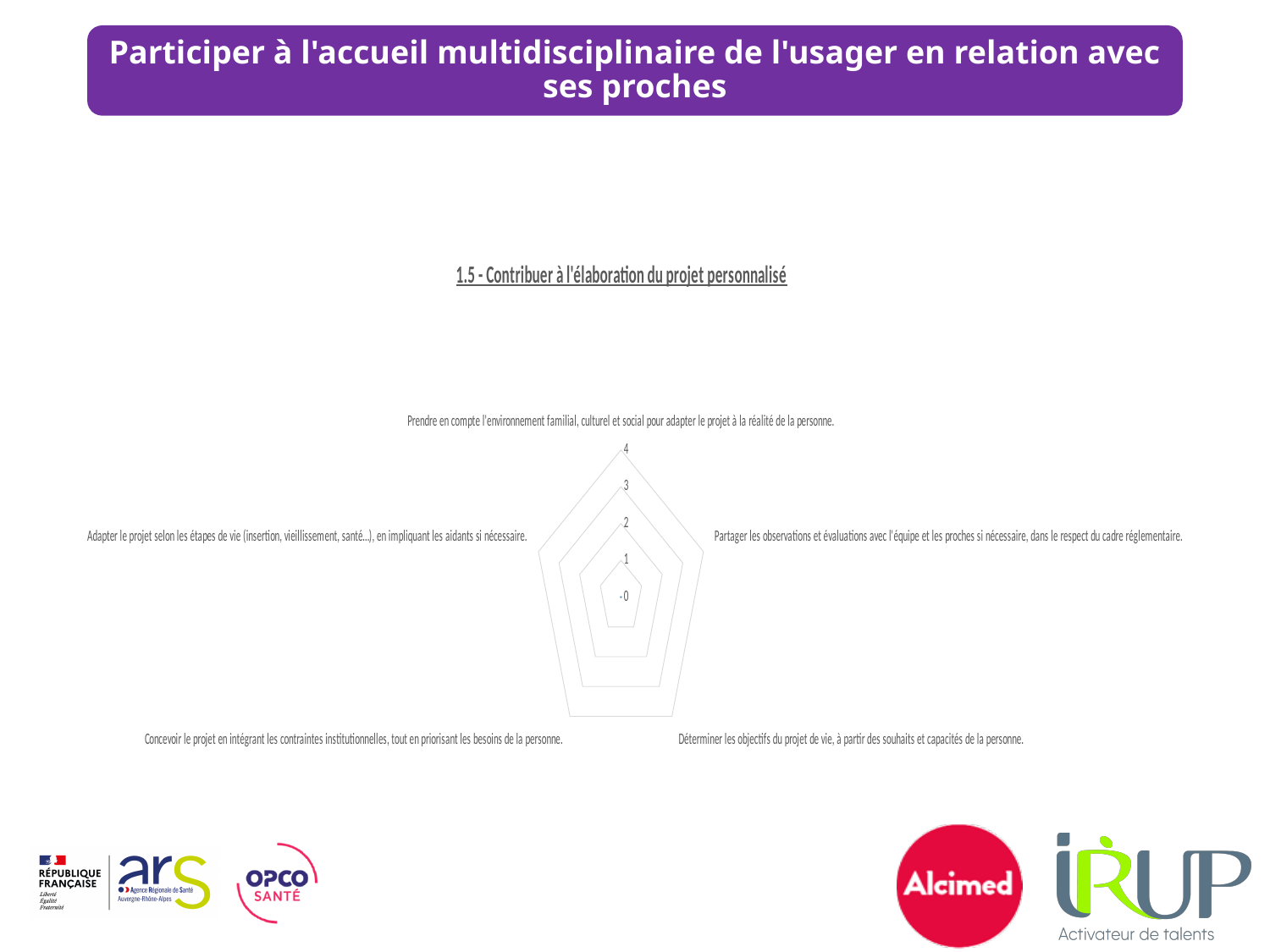
Which category label appears at the top of the radar chart? Prendre en compte l'environnement familial, culturel et social pour adapter le projet à la réalité de la personne. What is the title of the radar chart? 1.5 - Contribuer à l'élaboration du projet personnalisé Which category label appears at the bottom left of the radar chart? Concevoir le projet en intégrant les contraintes institutionnelles, tout en priorisant les besoins de la personne. What is the highest value shown on the radar chart's scale? 4 What kind of chart is shown on the slide? Radar chart Which category label appears at the bottom right of the radar chart? Déterminer les objectifs du projet de vie, à partir des souhaits et capacités de la personne. How many categories (axes) does the radar chart have? 5